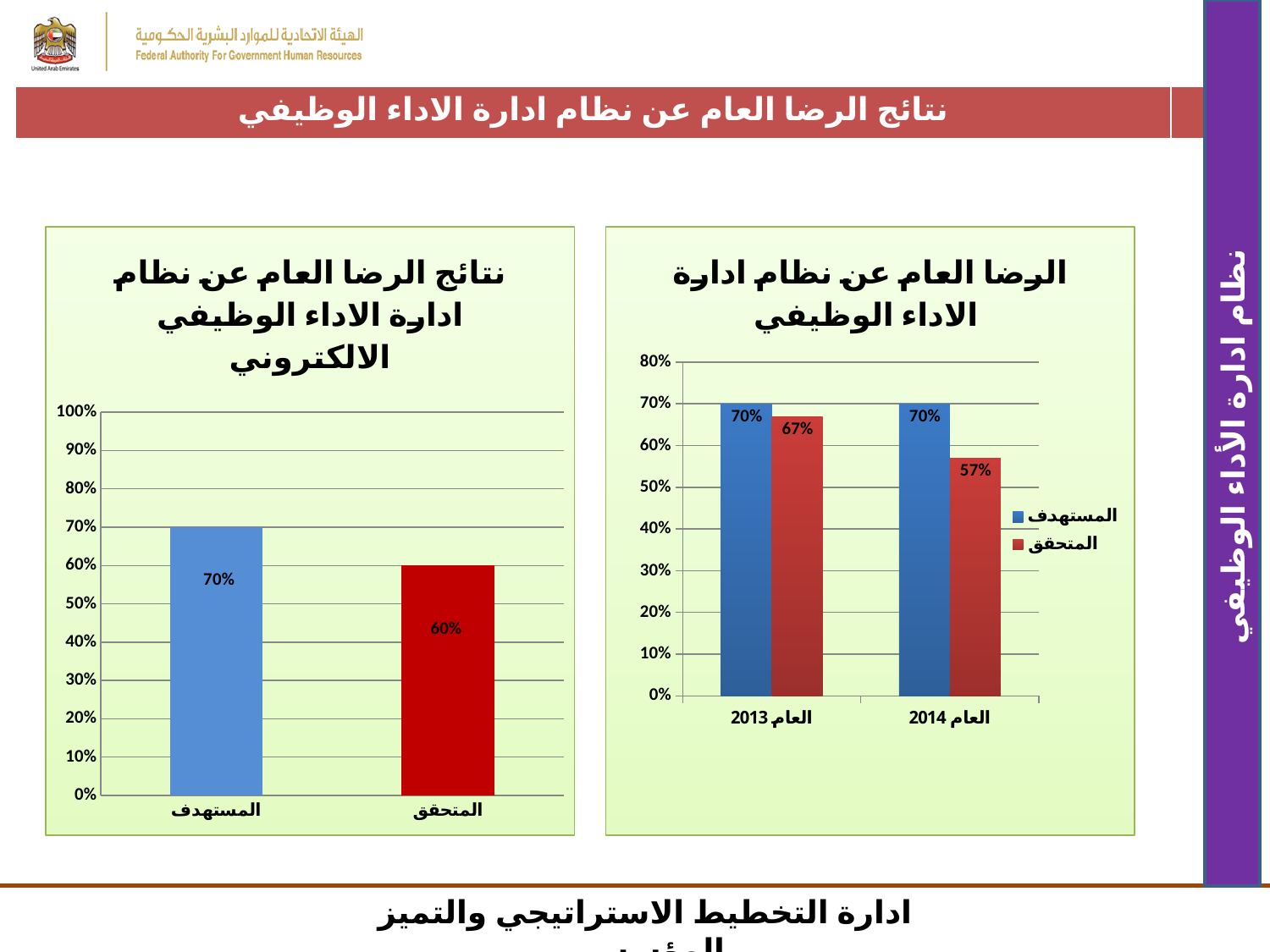
What type of chart is the right chart (الرضا العام عن نظام ادارة الاداء الوظيفي)? bar chart In the right chart, how many series does the legend list? 2 In the right chart, does the value of المتحقق rise or fall from العام 2013 to العام 2014? fall In the left chart (نتائج الرضا العام عن نظام ادارة الاداء الوظيفي الالكتروني), what is the value for المستهدف? 70% In the left chart, what is the difference between المستهدف and المتحقق? 10% In the left chart (نتائج الرضا العام عن نظام ادارة الاداء الوظيفي الالكتروني), what is the value for المتحقق? 60% In the right chart, what is the value of المستهدف for العام 2014? 70% In the right chart, what is the difference between المستهدف and المتحقق for العام 2014? 13% In the right chart (الرضا العام عن نظام ادارة الاداء الوظيفي), what is the value of المتحقق for العام 2013? 67% In the left chart, which category has the lower value? المتحقق In the right chart (الرضا العام عن نظام ادارة الاداء الوظيفي), what is the value of المتحقق for العام 2014? 57% In the left chart, how many bars are plotted? 2